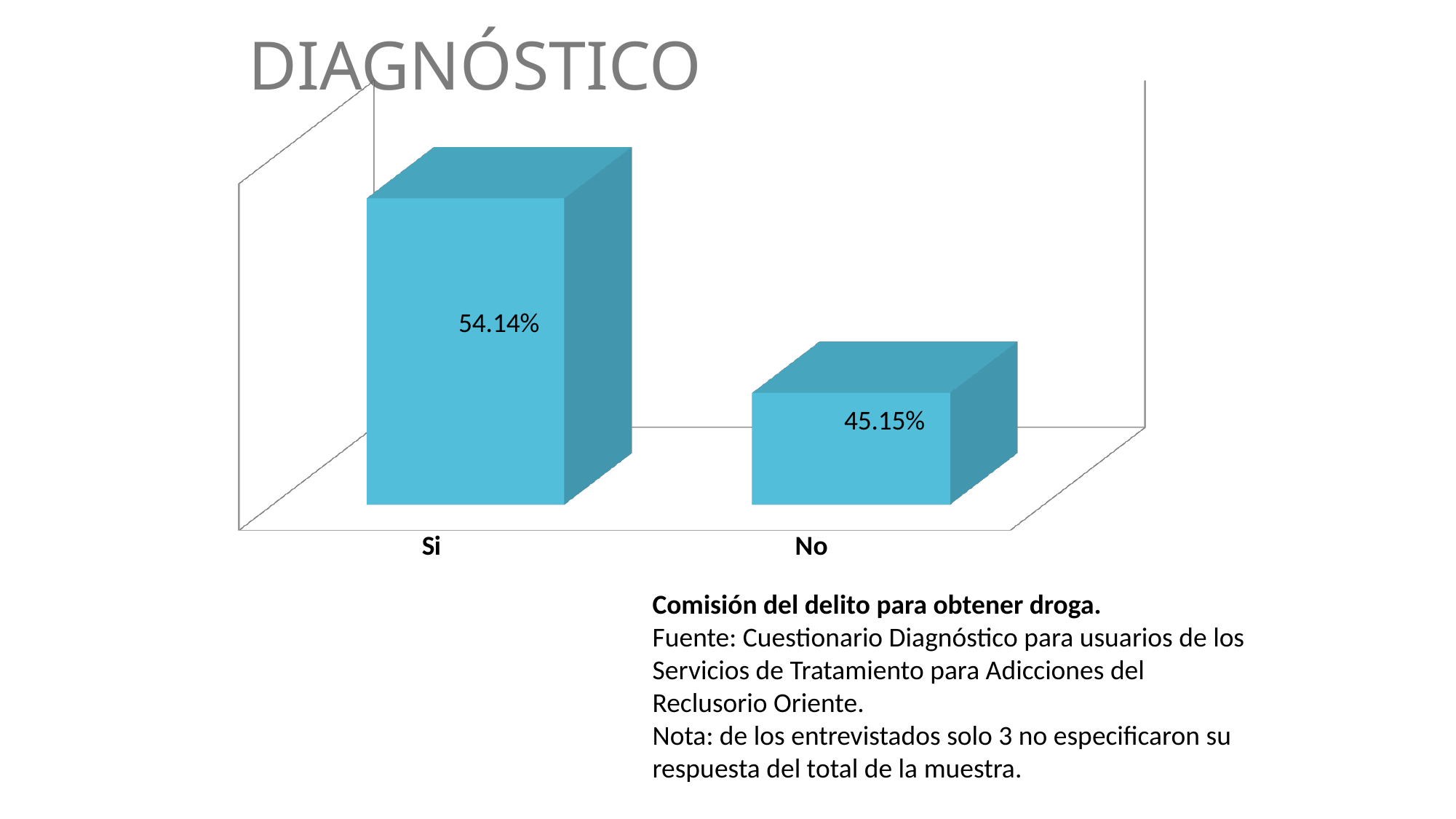
Which category has the lowest value? No What is the difference between the values for Si and No? 8.99% Which category has the highest value? Si What is the title shown at the top of the slide? DIAGNÓSTICO What is the value for No? 45.15% What kind of chart is shown on the slide? Bar chart Do the values rise or fall from Si to No? Fall What colour are the bars in the chart? Blue What is the value for Si? 54.14% How many categories are shown in the chart? 2 Which is larger, the value for Si or the value for No? Si